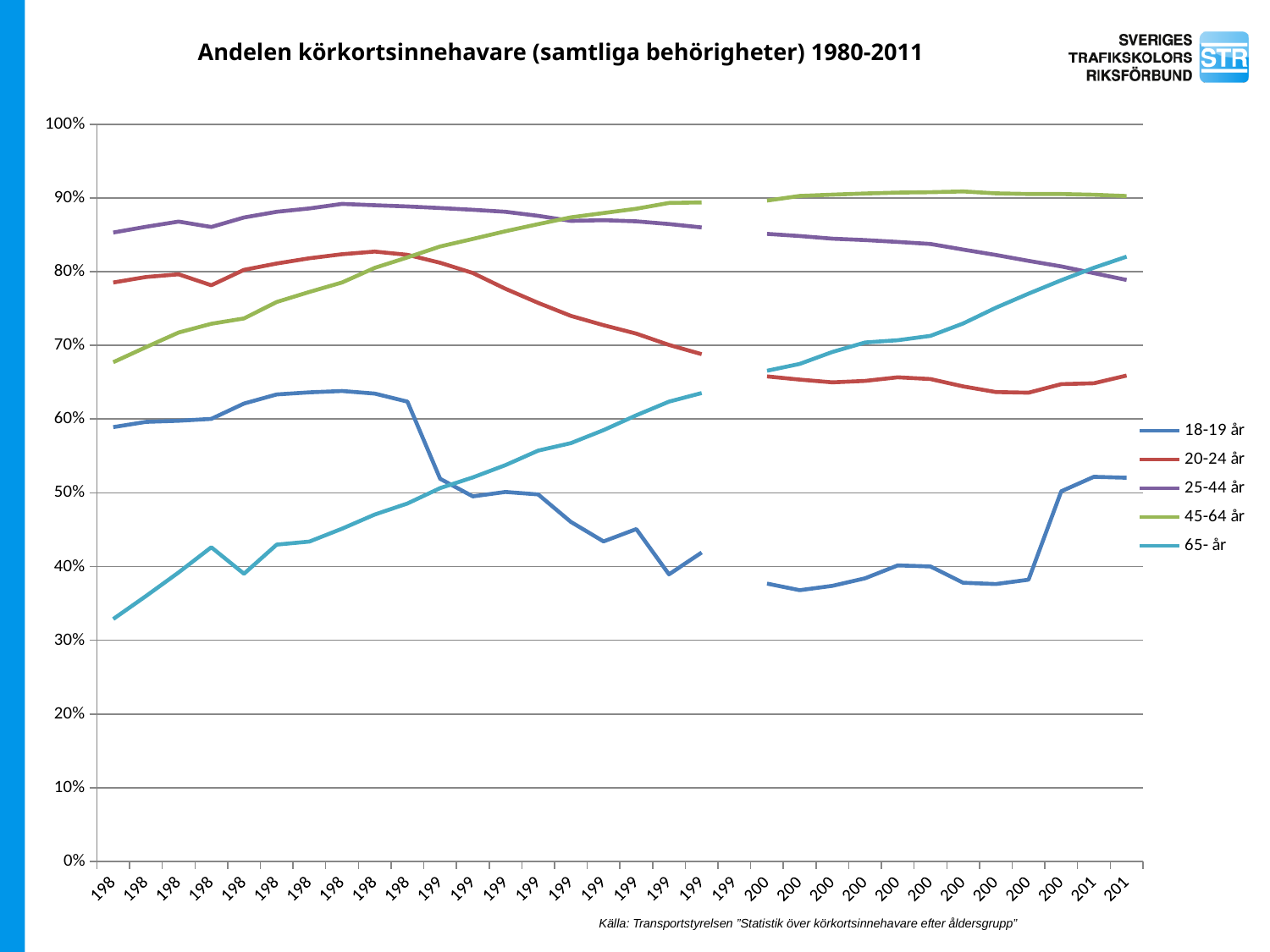
At the right end of the chart, which is larger: the value for 65- år or the value for 25-44 år? 65- år How many series does the legend list? 5 Is the value for 65- år at the left end of the chart greater or less than 40%? less Does the 65- år series rise or fall over the period shown? rise Which series has the lowest value at the left end of the chart? 65- år What is the title of the chart? Andelen körkortsinnehavare (samtliga behörigheter) 1980-2011 Which series has the highest value at the left end of the chart? 25-44 år What kind of chart is shown on the slide? line chart Does the 20-24 år series rise or fall from the left end to the right end of the chart? fall Which age group is drawn with the green line? 45-64 år Which series has the lowest value at the right end of the chart? 18-19 år Which series has the highest value at the right end of the chart? 45-64 år